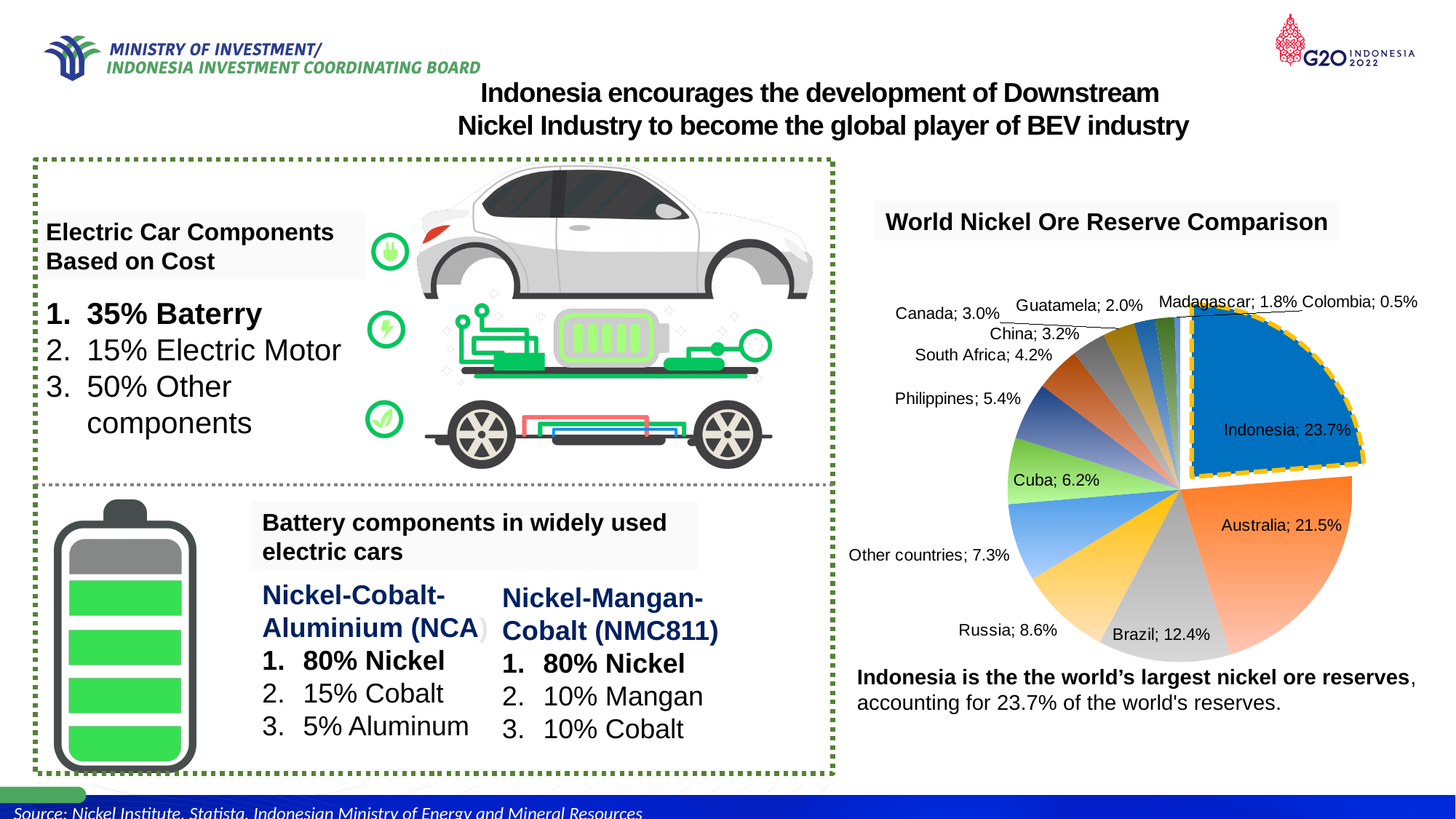
Which has a larger share in the pie chart, Cuba or Philippines? Cuba Which country has the largest slice in the World Nickel Ore Reserve Comparison chart? Indonesia What share of world nickel ore reserves does Indonesia hold according to the pie chart? 23.7% What is the difference between Indonesia's and Australia's shares in the pie chart? 2.2% What is the value shown for Other countries in the pie chart? 7.3% What kind of chart is the World Nickel Ore Reserve Comparison chart? Pie chart Which country has the smallest slice in the World Nickel Ore Reserve Comparison chart? Colombia How many slices does the World Nickel Ore Reserve Comparison pie chart have? 13 What is the value shown for Australia in the World Nickel Ore Reserve Comparison chart? 21.5% What is the title of the pie chart on the slide? World Nickel Ore Reserve Comparison What is the value shown for Russia in the pie chart? 8.6% What is the value shown for Brazil in the pie chart? 12.4%